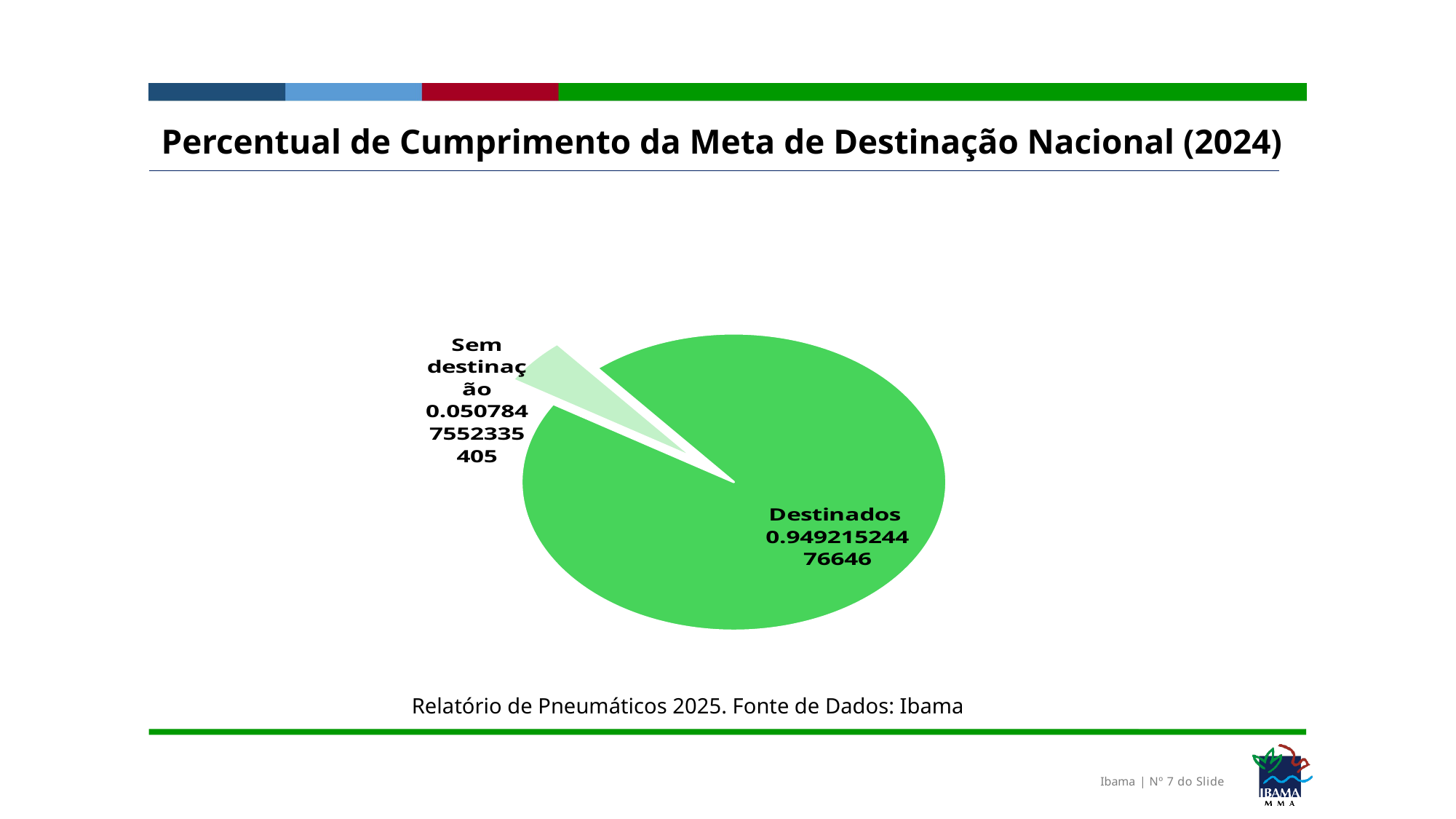
What is the title of the slide containing the pie chart? Percentual de Cumprimento da Meta de Destinação Nacional (2024) Which slice of the pie is the smallest? Sem destinação What is the value shown for the Sem destinação slice? 0.0507847552335405 What data source is cited below the pie chart? Relatório de Pneumáticos 2025. Fonte de Dados: Ibama Which slice of the pie is the largest? Destinados How many slices does the pie chart have? 2 Which is larger, the Destinados slice or the Sem destinação slice? Destinados What is the value shown for the Destinados slice? 0.94921524476646 What kind of chart is shown on the slide? pie chart